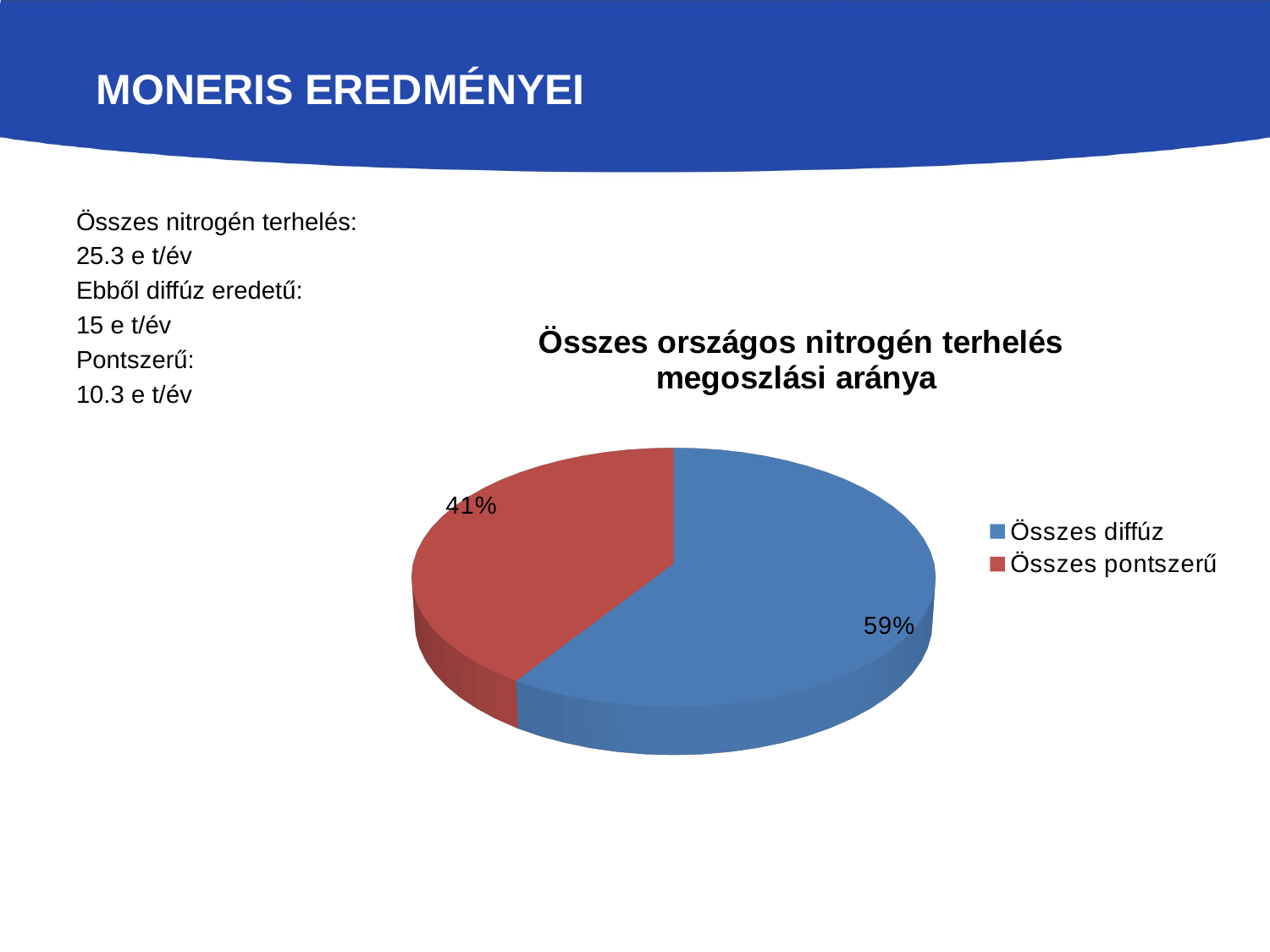
What is the chart's title? Összes országos nitrogén terhelés megoszlási aránya How many entries does the legend list? 2 What share of the pie does Összes pontszerű have? 41% How many slices does the pie chart have? 2 What share of the pie does Összes diffúz have? 59% Which is larger, Összes diffúz or Összes pontszerű? Összes diffúz What kind of chart is shown on the slide? pie chart Which slice is the smallest? Összes pontszerű Is the share for Összes pontszerű greater or less than 50%? less What is the difference in percentage points between Összes diffúz and Összes pontszerű? 18 Which slice is the largest? Összes diffúz What colour is the Összes pontszerű slice? red